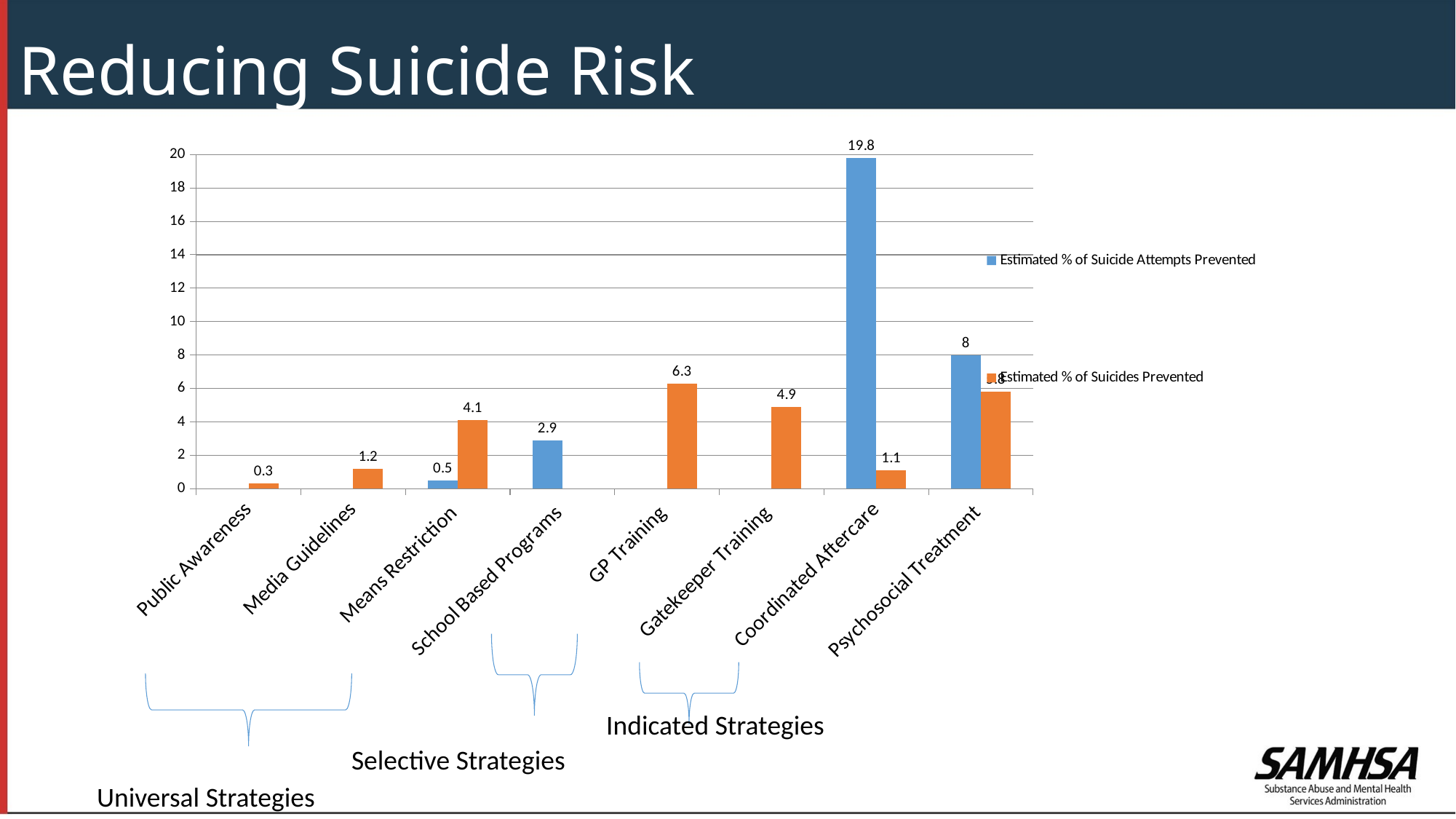
Which strategy has the lowest Estimated % of Suicides Prevented? Public Awareness For Coordinated Aftercare, what is the difference between the Estimated % of Suicide Attempts Prevented and the Estimated % of Suicides Prevented? 18.7 How many strategies are shown on the x axis of the chart? 8 What is the Estimated % of Suicide Attempts Prevented for Coordinated Aftercare? 19.8 For Means Restriction, which is larger: the Estimated % of Suicide Attempts Prevented or the Estimated % of Suicides Prevented? Estimated % of Suicides Prevented What is the Estimated % of Suicide Attempts Prevented for Psychosocial Treatment? 8 How many series does the chart legend list? 2 Is the Estimated % of Suicides Prevented for Psychosocial Treatment greater or less than 4? greater What is the Estimated % of Suicides Prevented for GP Training? 6.3 Which strategy has the highest Estimated % of Suicide Attempts Prevented? Coordinated Aftercare What is the difference in Estimated % of Suicides Prevented between GP Training and Gatekeeper Training? 1.4 What is the Estimated % of Suicides Prevented for Means Restriction? 4.1